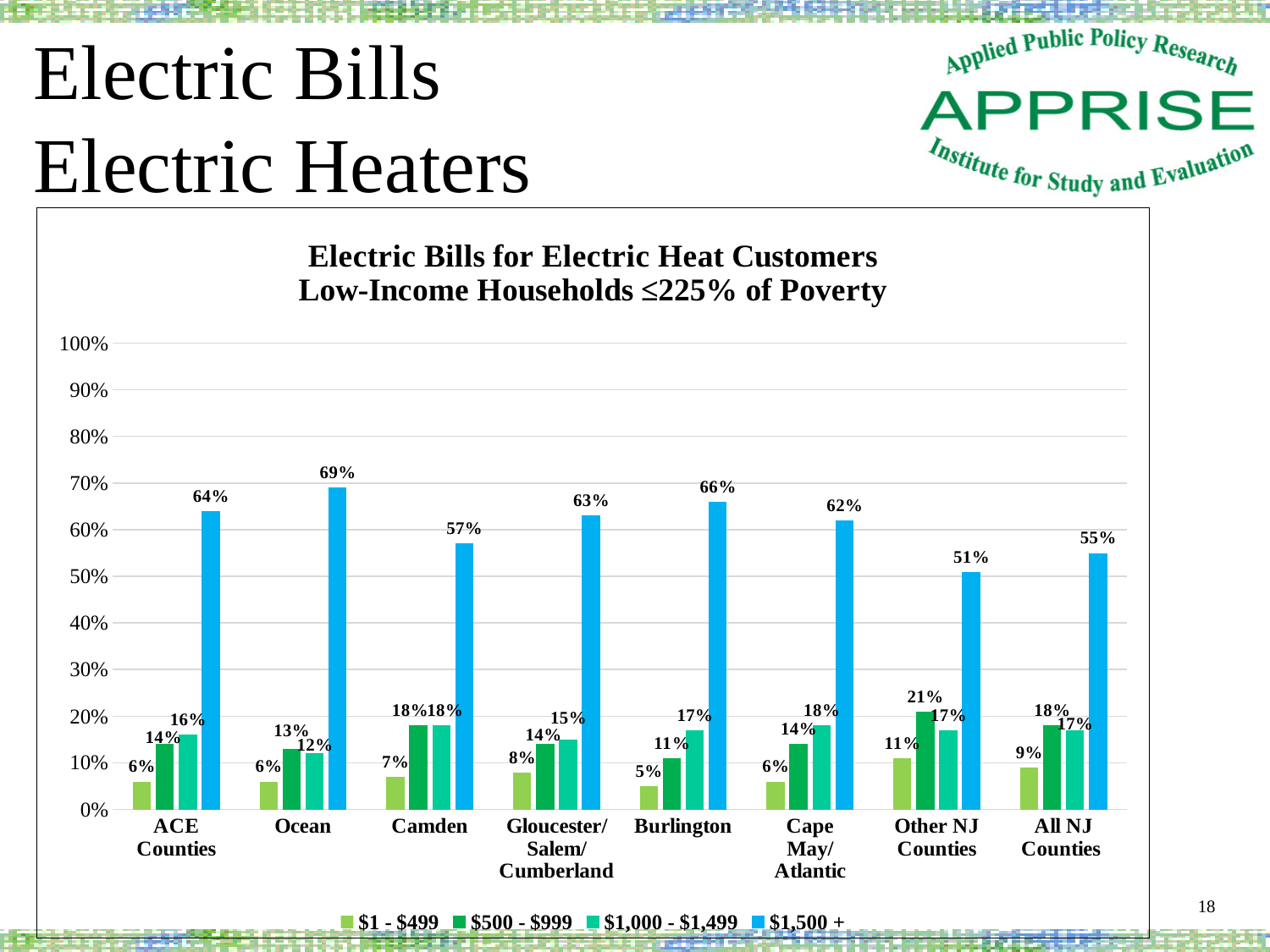
What kind of chart is shown on the slide? Bar chart Which category has the lowest value for the $1,500 + series? Other NJ Counties What is the difference between the $1,500 + values for ACE Counties and All NJ Counties? 9% How many series does the legend list? 4 How many categories are shown on the x axis? 8 What percentage of electric heat customers in Ocean have electric bills of $1,500 +? 69% What is the value for the $500 - $999 series for Other NJ Counties? 21% Is the $1,500 + value for Burlington greater or less than 60%? greater Which category has the highest value for the $1,500 + series? Ocean Which is larger: the $1,500 + value for Camden or for Cape May/Atlantic? Cape May/Atlantic What is the value for the $1 - $499 series for Burlington? 5% What is the title of the chart? Electric Bills for Electric Heat Customers Low-Income Households ≤225% of Poverty